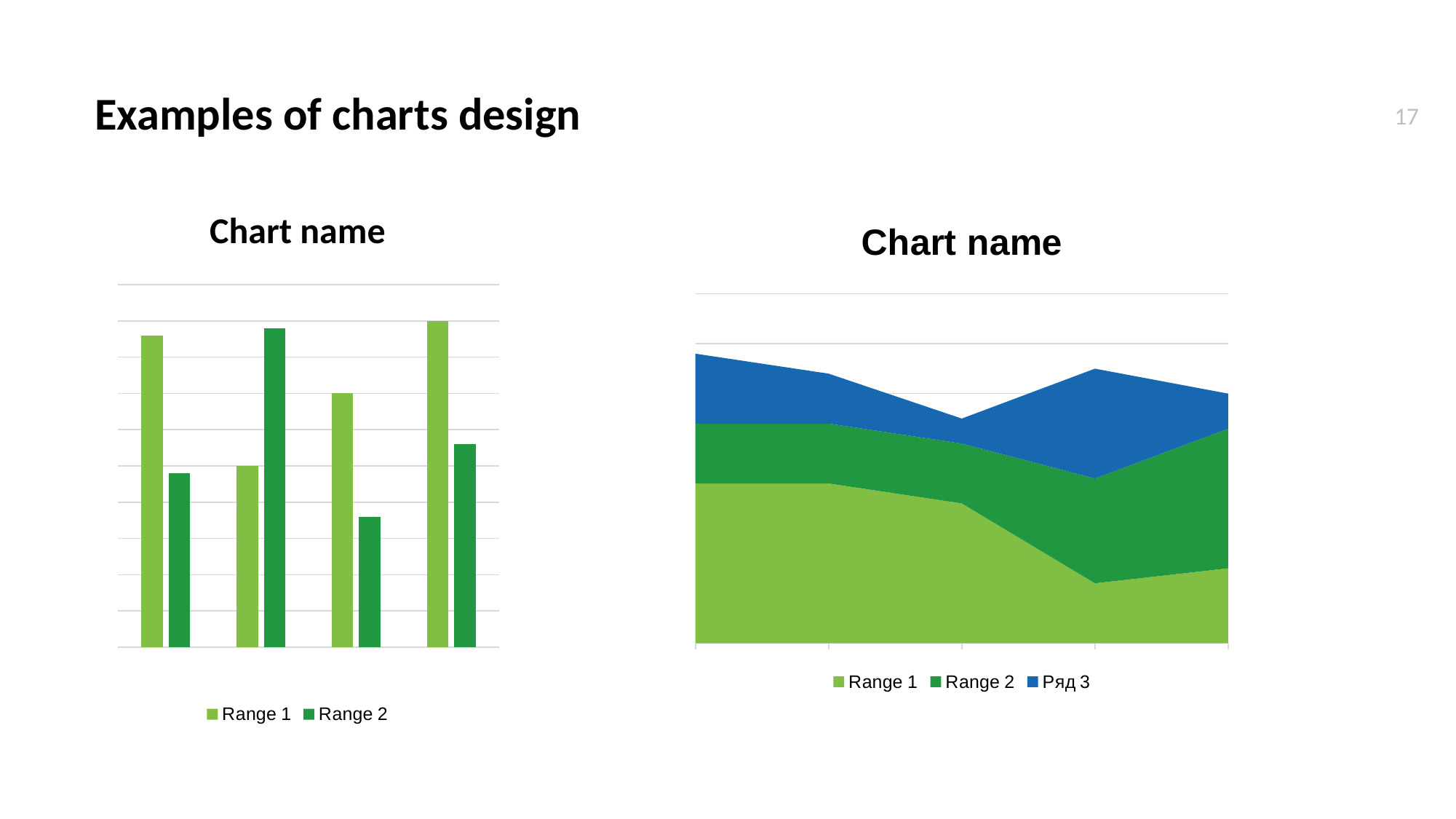
What is the title of the left chart? Chart name What are the legend entries of the right chart? Range 1, Range 2, Ряд 3 How many bars in total are shown in the left chart? 8 In the right chart, does the Range 1 area rise or fall from the leftmost point to the rightmost point? fall What kind of chart is the right chart on the slide? area chart How many series does the legend of the left chart list? 2 How many series does the legend of the right chart list? 3 In the left chart, in the second group of bars from the left, which series has the taller bar, Range 1 or Range 2? Range 2 In the left chart, in the leftmost group of bars, which series has the taller bar, Range 1 or Range 2? Range 1 How many groups of bars are shown in the left chart? 4 In the left chart, in the rightmost group of bars, which series has the taller bar, Range 1 or Range 2? Range 1 What kind of chart is the left chart on the slide? bar chart